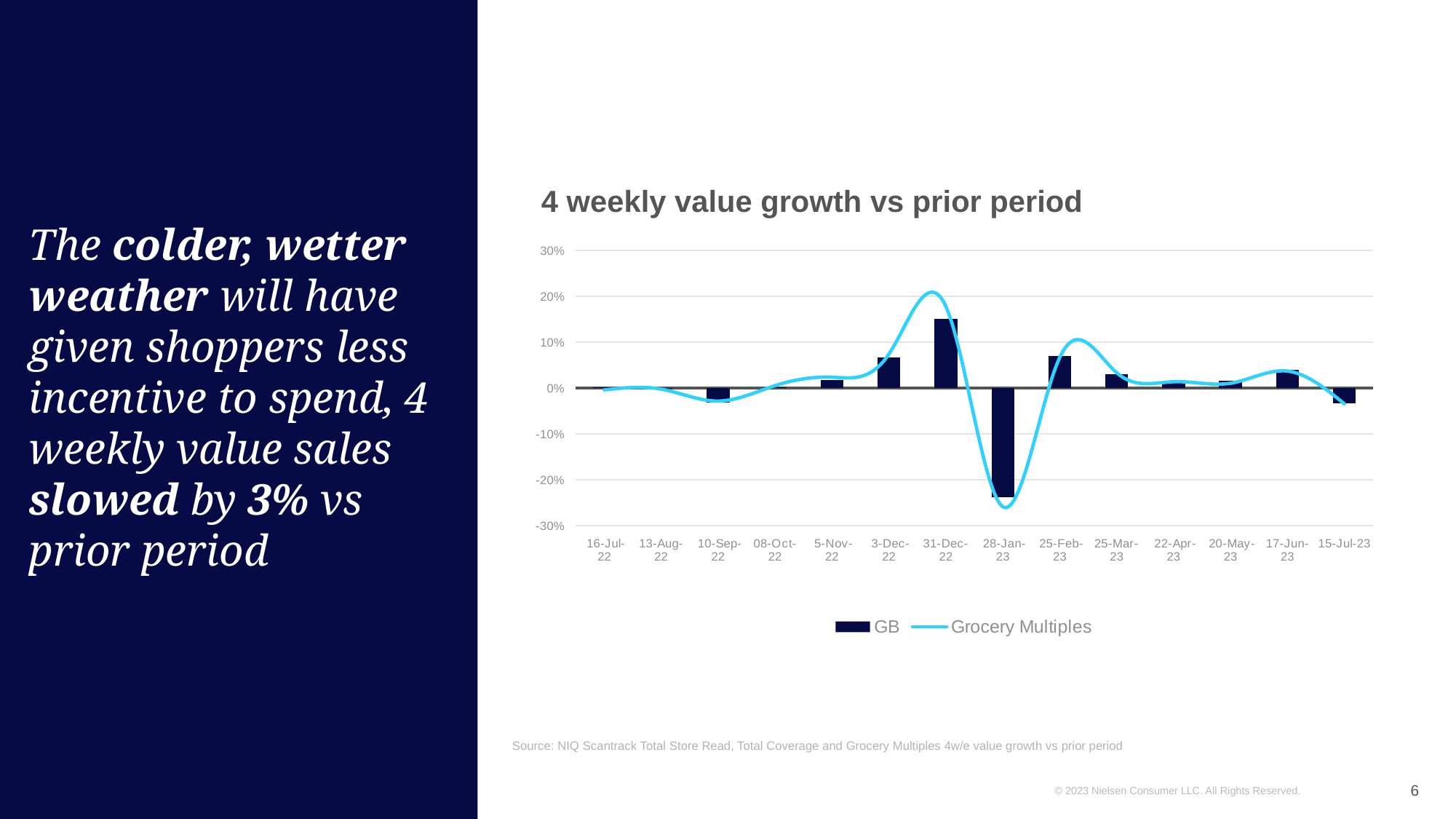
What kind of chart is shown on the slide? Combined bar and line chart Which series is drawn as a line in the chart? Grocery Multiples How many time periods are shown along the x axis of the chart? 14 Is the GB value for 31-Dec-22 greater or less than 10%? greater What is the title of the chart? 4 weekly value growth vs prior period Is the GB value for 28-Jan-23 greater or less than -20%? less In which period is the GB bar highest? 31-Dec-22 In which period is the GB bar lowest? 28-Jan-23 Which is larger, the GB value for 31-Dec-22 or the GB value for 25-Feb-23? 31-Dec-22 Is the Grocery Multiples value for 28-Jan-23 greater or less than -20%? less How many series does the chart legend list? 2